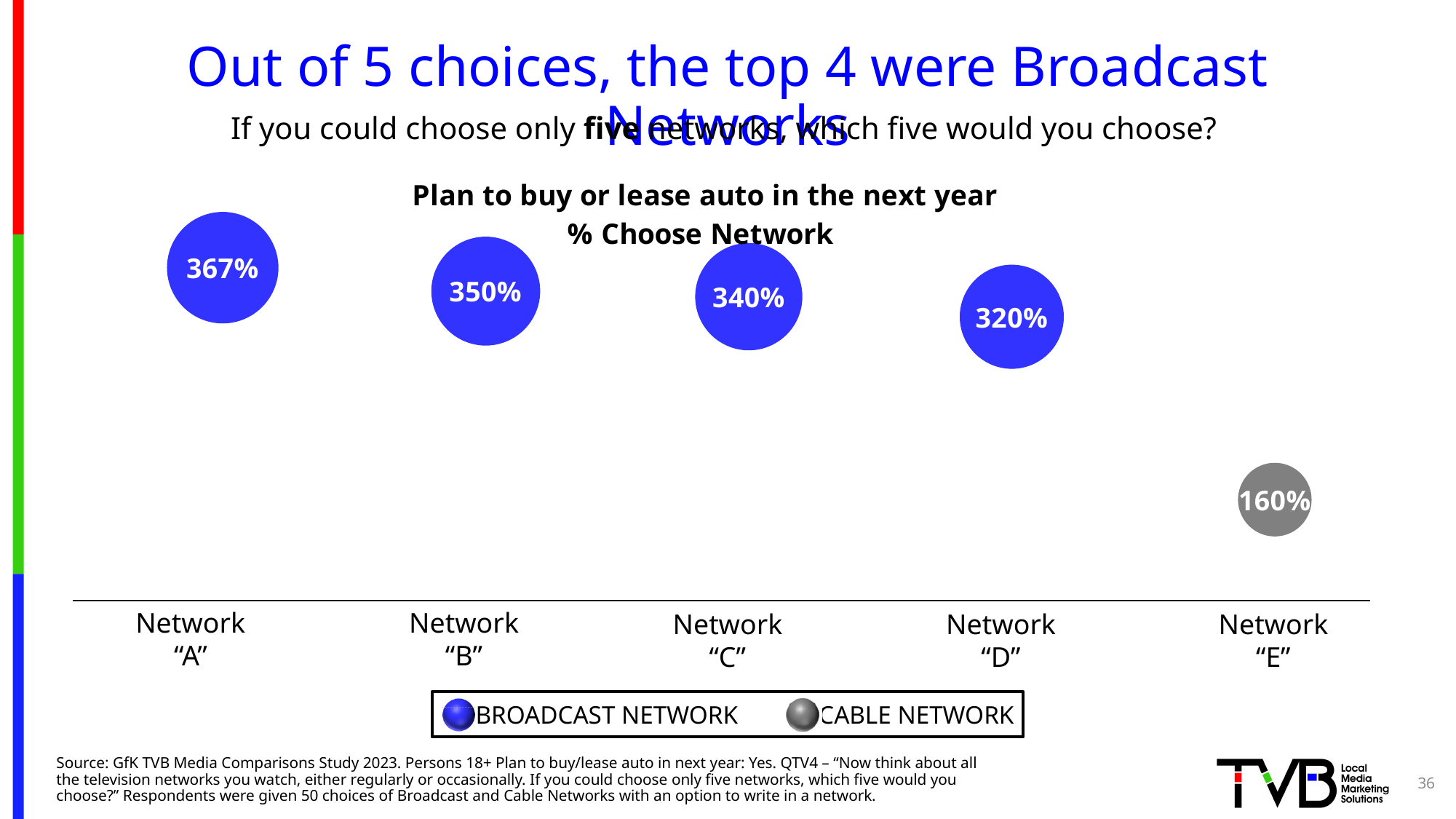
Which network has the highest value? Network "A" Which network has the lowest value? Network "E" How many entries does the legend list? 2 What is the value for Network "C"? 340% What kind of chart is shown on the slide? Bubble chart Which network is shown as a Cable Network in the chart? Network "E" What is the value for Network "A"? 367% Which is larger, the value for Network "B" or Network "C"? Network "B" What is the value for Network "E"? 160% What is the difference between the values for Network "B" and Network "D"? 30% How many networks are shown in the chart? 5 What is the difference between the values for Network "A" and Network "E"? 207%